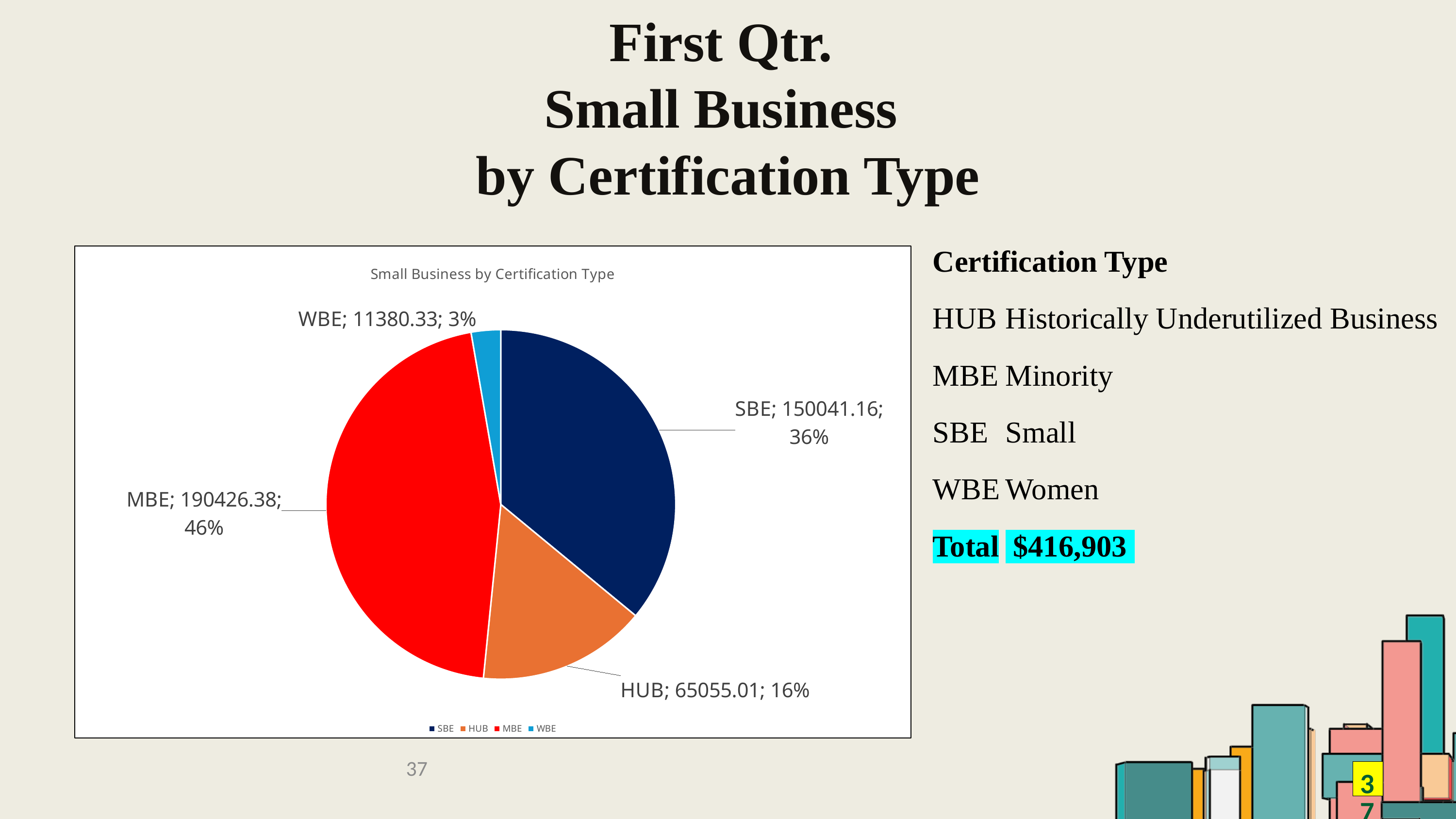
What is the value for SBE in the pie chart? 150041.16 How many categories does the pie chart show? 4 What type of chart is shown on the slide? Pie chart What is the value for WBE in the pie chart? 11380.33 Which certification type has the largest slice of the pie? MBE What is the value for MBE in the pie chart? 190426.38 Which is larger, the value for SBE or the value for HUB? SBE Which certification type has the smallest slice of the pie? WBE What share of the pie does HUB represent? 16% What is the difference between the MBE and SBE values? 40385.22 What share of the pie does SBE represent? 36% What is the value for HUB in the pie chart? 65055.01